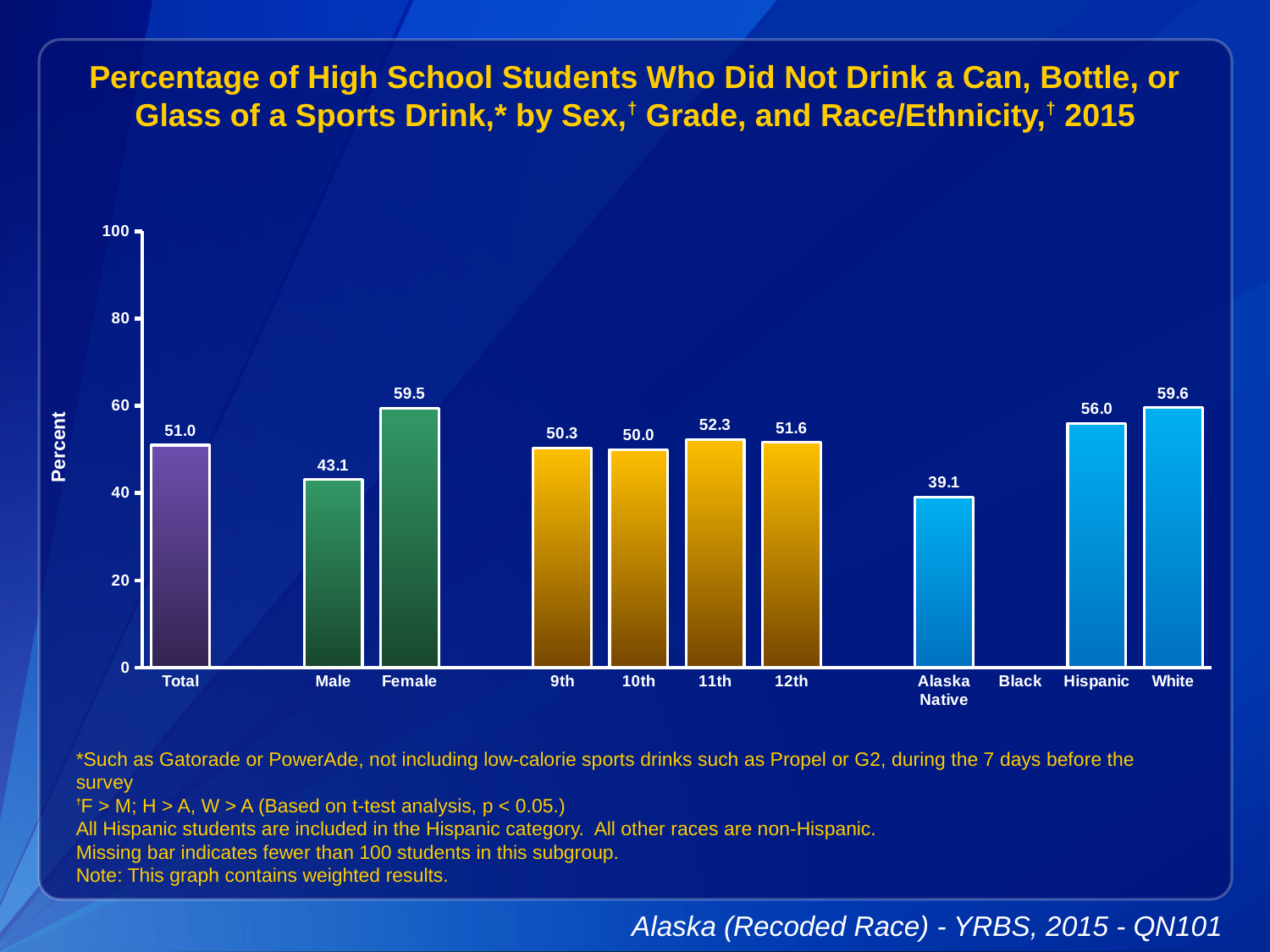
Which category has the highest value? White What is the value for Alaska Native? 39.1 What is the value for Female? 59.5 How many bars are plotted on the chart? 10 Which category has the lowest value among the bars shown? Alaska Native What is the difference between the Female and Male values? 16.4 What kind of chart is shown? bar chart What is the value for Total? 51.0 What is the value for 11th grade? 52.3 What is the label on the y axis? Percent Which is larger, the value for Hispanic or the value for 12th grade? Hispanic Is the value for Male greater or less than 40? greater